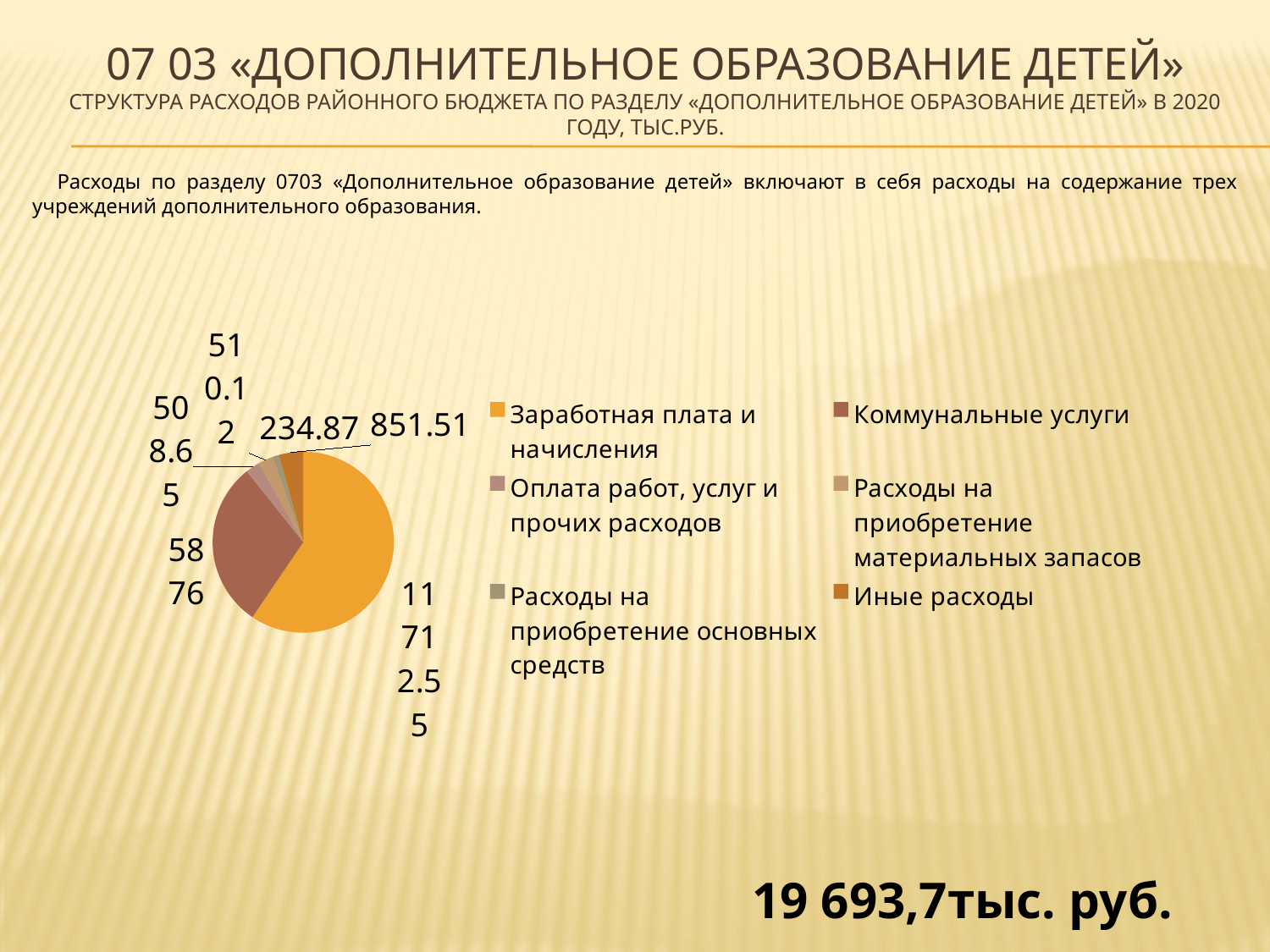
What total amount in thousand rubles is printed at the bottom right of the slide? 19 693,7тыс. руб. What is the difference between the values for Иные расходы and Расходы на приобретение материальных запасов? 341.39 What is the value for Иные расходы in the pie chart? 851.51 Which legend entry is shown in the largest orange colour of the pie chart? Заработная плата и начисления Which category has the smallest slice in the pie chart? Расходы на приобретение основных средств How many entries does the legend of the pie chart list? 6 What is the value for Коммунальные услуги in the pie chart? 5876 Which is larger in the pie chart: Заработная плата и начисления or Коммунальные услуги? Заработная плата и начисления What kind of chart is shown on the slide? pie chart Which category has the largest slice in the pie chart? Заработная плата и начисления How many categories does the pie chart have? 6 What is the value for Расходы на приобретение материальных запасов in the pie chart? 510.12